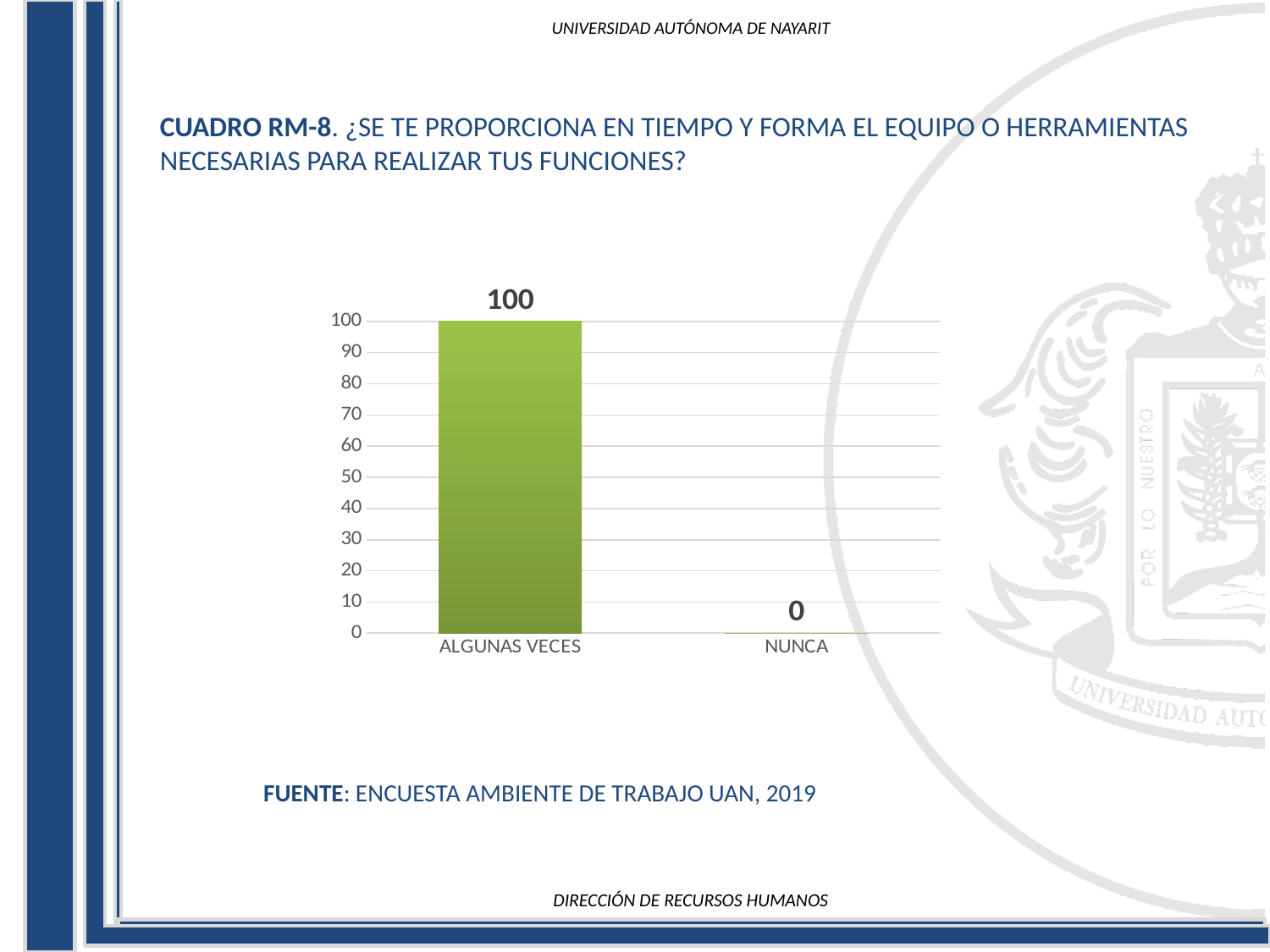
Which category has the lowest value? NUNCA Do the values rise or fall from ALGUNAS VECES to NUNCA? fall How many categories are shown on the x axis? 2 What source is cited below the chart? ENCUESTA AMBIENTE DE TRABAJO UAN, 2019 What is the value for ALGUNAS VECES? 100 Which category has the highest value? ALGUNAS VECES What is the highest value shown on the y axis? 100 What kind of chart is shown on the slide? bar chart Is the value for ALGUNAS VECES greater or less than 50? greater What is the value for NUNCA? 0 Which is larger, the value for ALGUNAS VECES or the value for NUNCA? ALGUNAS VECES What is the difference between the values for ALGUNAS VECES and NUNCA? 100